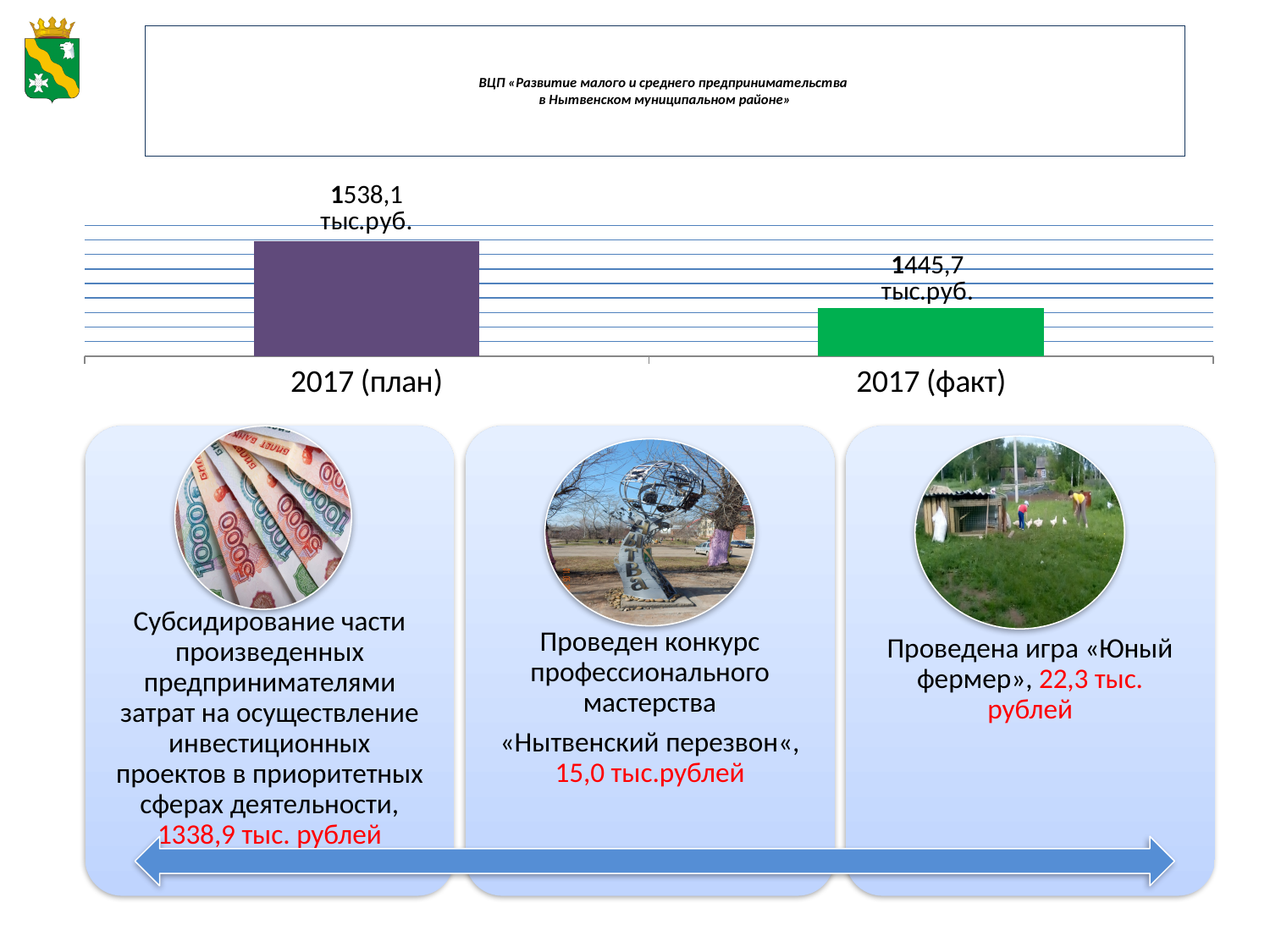
How many bars are plotted in the chart? 2 Which category has the higher value, 2017 (план) or 2017 (факт)? 2017 (план) What is the value shown for 2017 (факт)? 1445,7 тыс.руб. Is the value for 2017 (факт) larger or smaller than the value for 2017 (план)? smaller What colour is the bar for 2017 (факт)? green What is the value shown for 2017 (план)? 1538,1 тыс.руб. What colour is the bar for 2017 (план)? purple What is the difference between the 2017 (план) value and the 2017 (факт) value? 92,4 тыс.руб. Do the values fall or rise from 2017 (план) to 2017 (факт)? fall What kind of chart is shown on the slide? bar chart Which category has the lowest value in the chart? 2017 (факт)